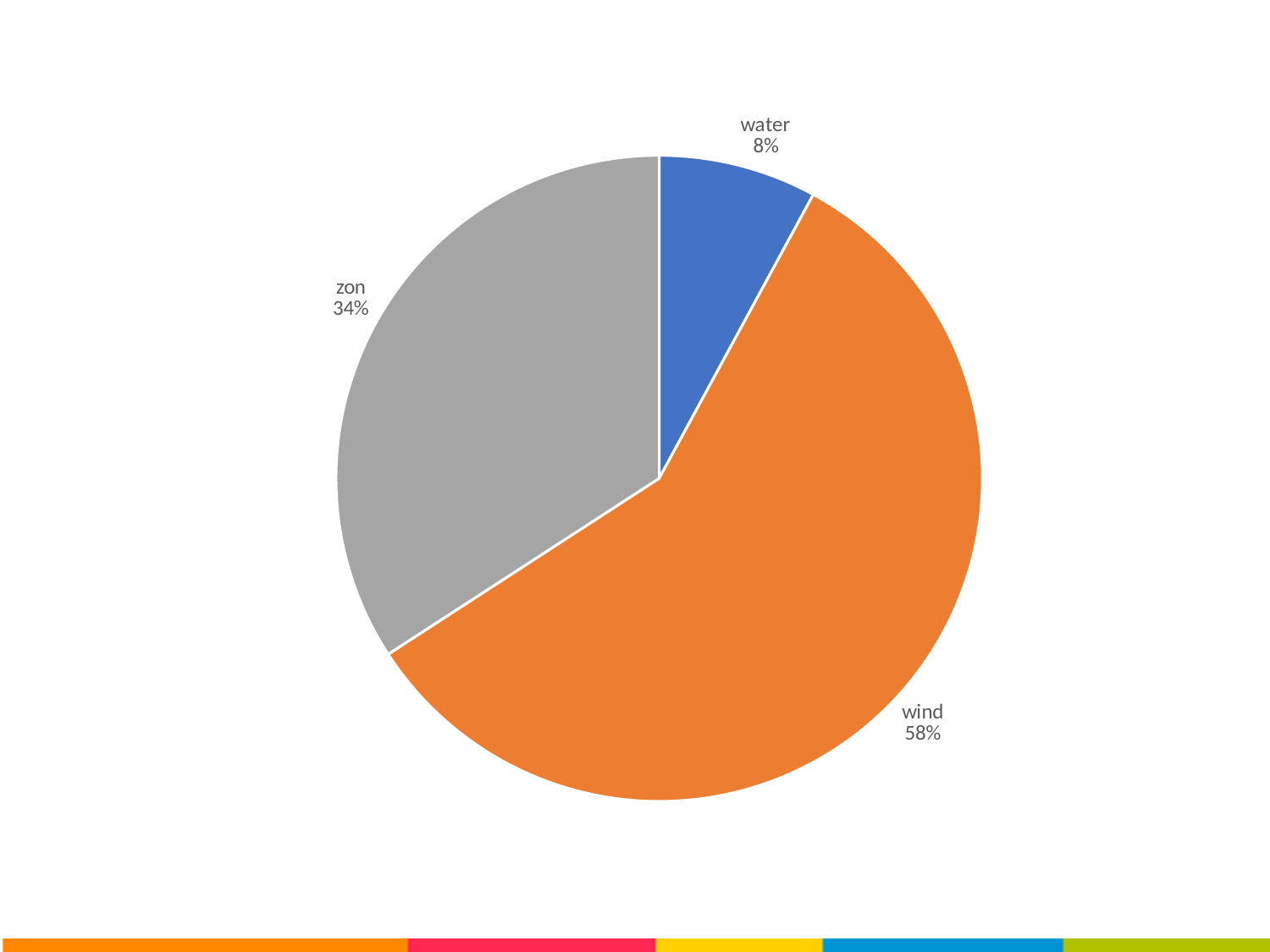
What is the difference in percentage points between zon and water? 26 What colour is the wind slice? orange How many slices does the pie chart have? 3 What colour is the water slice? blue Which category has the smallest slice of the pie? water What share of the pie does water have? 8% What is the difference in percentage points between wind and zon? 24 What share of the pie does zon have? 34% What kind of chart is shown on the slide? pie chart Which category has the largest slice of the pie? wind Which is larger, the share for zon or the share for water? zon What share of the pie does wind have? 58%